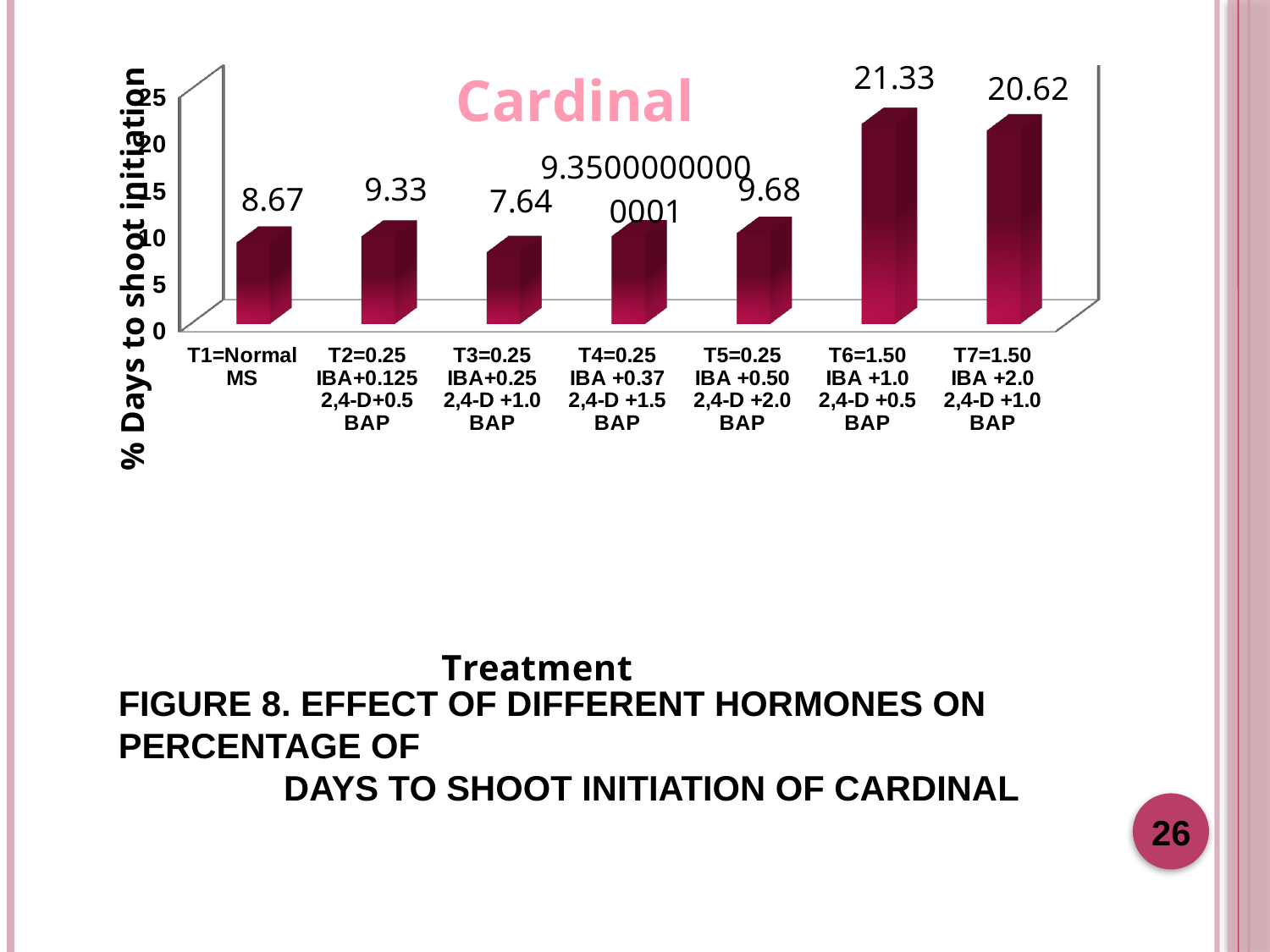
Which treatment has the highest value? T6=1.50 IBA +1.0 2,4-D +0.5 BAP How many treatments are shown on the x axis? 7 What is the difference between the values for T6 and T7? 0.71 What is the value for T3=0.25 IBA+0.25 2,4-D +1.0 BAP? 7.64 What is the title of the chart? Cardinal What is the value for T1=Normal MS? 8.67 Is the value for T7 greater or less than 15? greater What is the value for T7=1.50 IBA +2.0 2,4-D +1.0 BAP? 20.62 What is the value for T6=1.50 IBA +1.0 2,4-D +0.5 BAP? 21.33 Which treatment has the lowest value? T3=0.25 IBA+0.25 2,4-D +1.0 BAP What kind of chart is shown on the slide? bar chart Which is larger, the value for T2 or the value for T5? T5